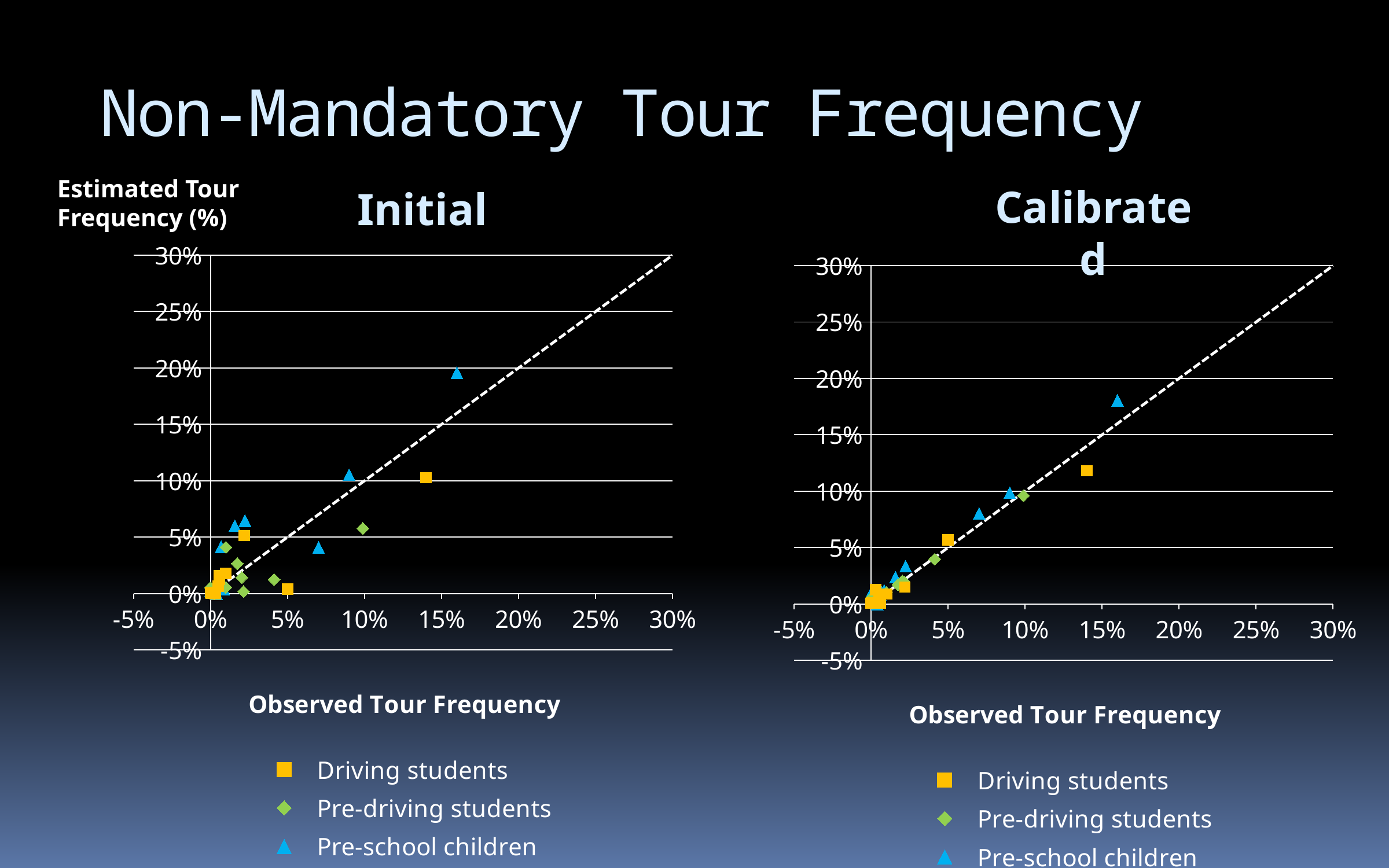
What are the legend entries of the Calibrated chart? Driving students, Pre-driving students, Pre-school children In the Calibrated chart, is the estimated tour frequency of the highest Driving students point greater or less than 15%? less What kind of chart is the Initial chart? scatter chart How many series does the legend of the Calibrated chart list? 3 In the Calibrated chart, which series has the point with the highest estimated tour frequency? Pre-school children In the Initial chart, which is higher on the vertical axis: the highest Pre-school children point or the highest Driving students point? Pre-school children How many series does the legend of the Initial chart list? 3 In the Initial chart, which series has the point with the highest estimated tour frequency? Pre-school children In the Initial chart, is the estimated tour frequency of the highest Pre-school children point greater or less than 15%? greater In the Calibrated chart, is the estimated tour frequency of the highest Pre-school children point greater or less than 20%? less What is the vertical axis title shown above the Initial chart? Estimated Tour Frequency (%)